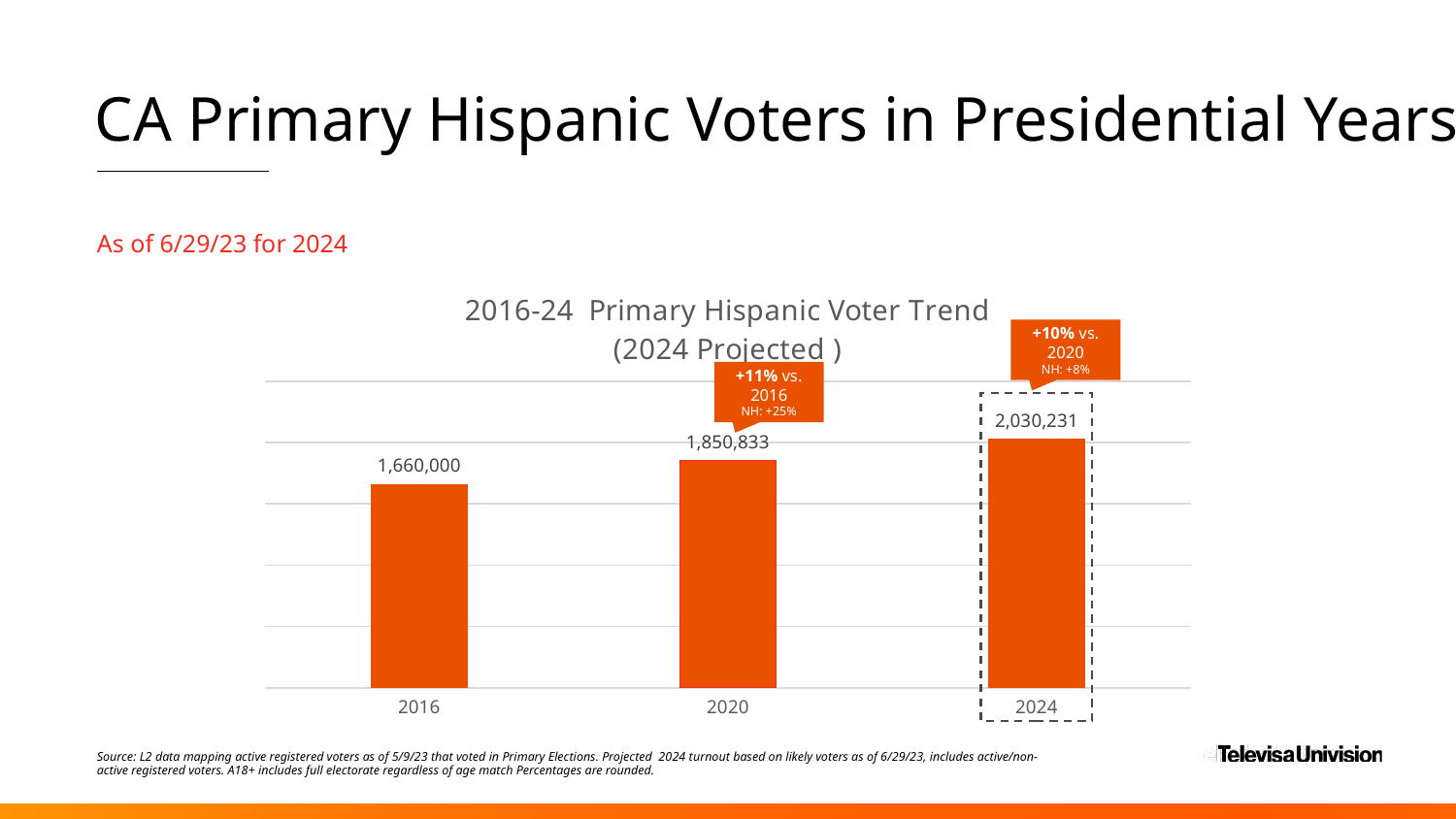
Do the values rise or fall from 2016 to 2024? Rise What is the value for 2016? 1,660,000 What is the value for 2020? 1,850,833 What kind of chart is shown? Bar chart How many years are shown on the chart? 3 Which is larger, the value for 2020 or the value for 2024? 2024 What is the difference between the 2020 and 2016 values? 190,833 What is the title of the chart? 2016-24 Primary Hispanic Voter Trend (2024 Projected ) What is the projected value for 2024? 2,030,231 Which year has the highest value? 2024 Which year has the lowest value? 2016 What is the difference between the 2024 and 2020 values? 179,398